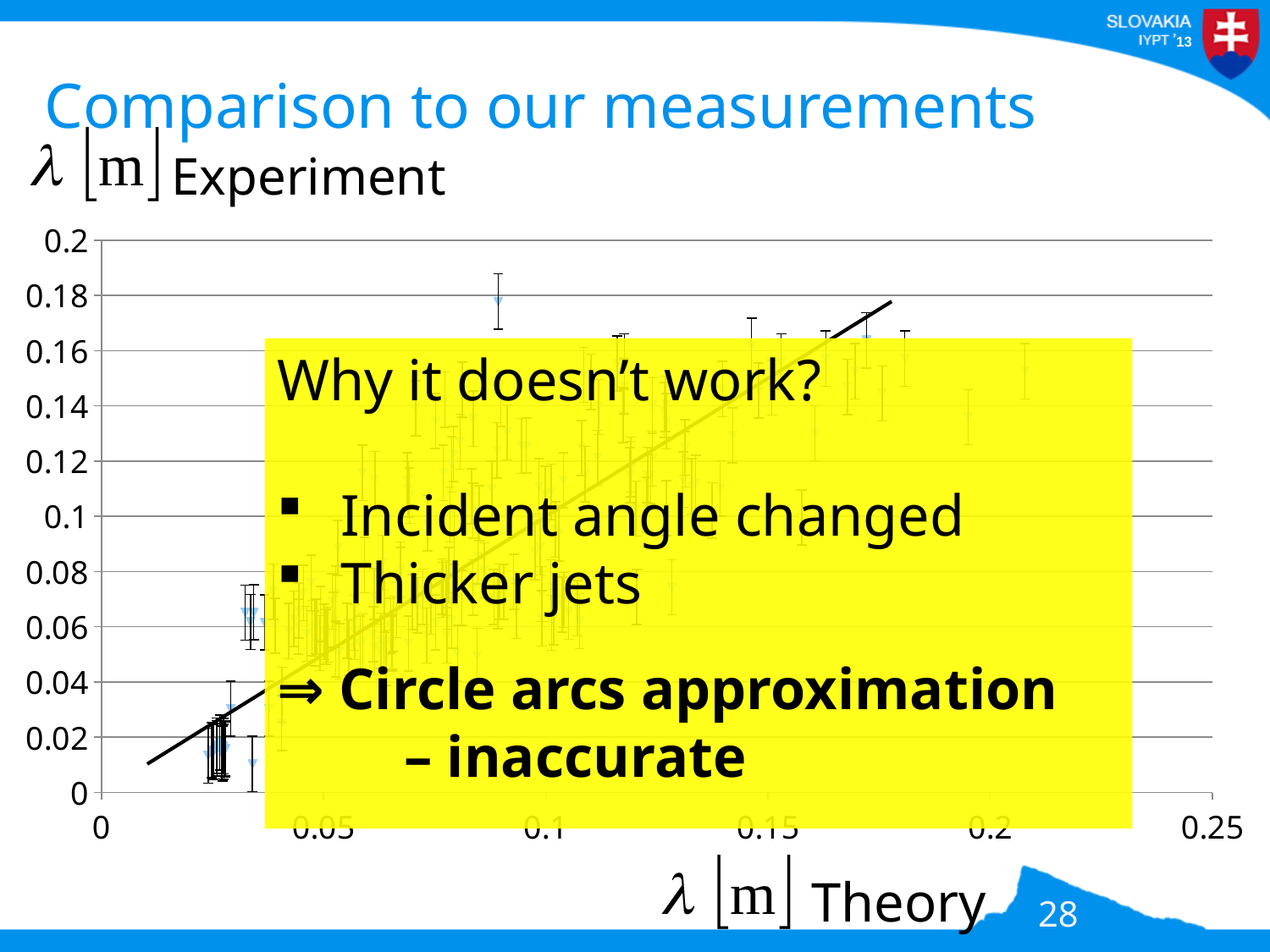
What is the label of the vertical axis of the chart? λ [m] Experiment Do the plotted experimental values generally rise or fall as the theoretical λ increases along the x axis? rise What is the step between consecutive tick values on the horizontal axis? 0.05 What is the step between consecutive tick values on the vertical axis? 0.02 What is the title of the slide containing the chart? Comparison to our measurements What kind of chart is shown on the slide? scatter chart What is the highest tick value shown on the vertical axis of the chart? 0.2 Does the fitted straight line on the chart slope upward or downward from left to right? upward What is the highest tick value shown on the horizontal axis of the chart? 0.25